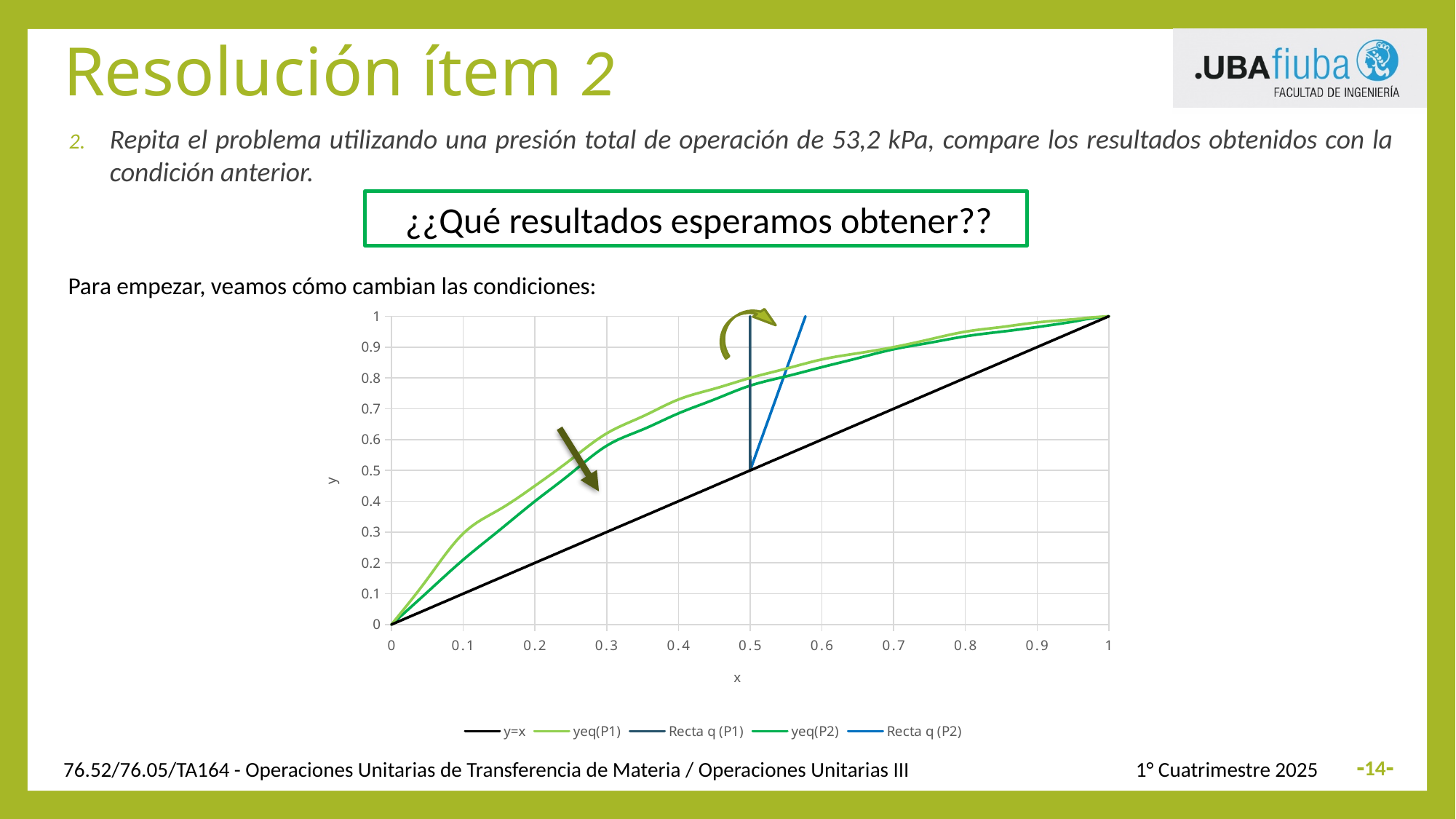
Is the value of yeq(P1) at x = 0.5 greater or less than 0.7? greater Is the value of yeq(P2) at x = 0.3 greater or less than 0.5? greater Is the value of yeq(P2) at x = 0.1 greater or less than 0.3? less How many series does the chart legend list? 5 Does the yeq(P2) series rise or fall as x increases from 0 to 1? rise What is the value of the y=x series at x = 0.5? 0.5 At x = 0.3, which series has the higher value, yeq(P1) or yeq(P2)? yeq(P1) What kind of chart is shown on the slide? line chart What is the value of the y=x series at x = 1? 1 What is the label of the vertical axis of the chart? y What is the label of the horizontal axis of the chart? x